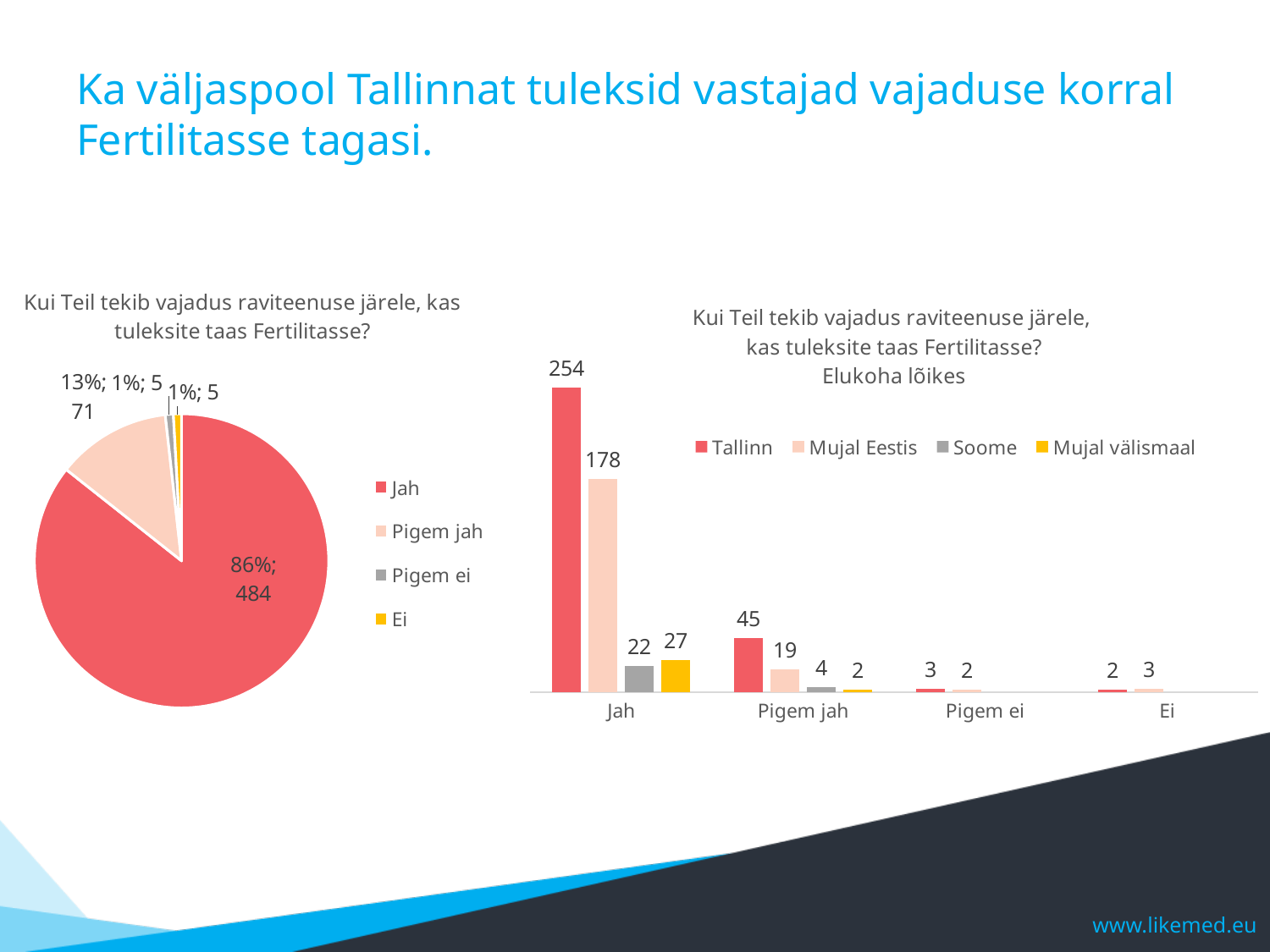
How many series does the legend of the bar chart on the right list? 4 In the bar chart on the right, what is the value for Mujal Eestis in the Pigem jah category? 19 In the bar chart on the right, what colour are the Mujal välismaal bars? Yellow In the bar chart on the right, which is larger in the Jah category: Soome or Mujal välismaal? Mujal välismaal What kind of chart is the chart on the right? Bar chart In the bar chart on the right, what is the value for Tallinn in the Jah category? 254 In the pie chart on the left, which category has the largest slice? Jah In the bar chart on the right, what is the difference between the Tallinn and Mujal Eestis values in the Jah category? 76 In the pie chart on the left, what percentage share does the Pigem jah slice have? 13% In the bar chart on the right, do the Tallinn values rise or fall from Jah to Ei along the x axis? Fall In the pie chart on the left, what value is shown for the Jah slice? 484 How many categories does the legend of the pie chart on the left list? 4